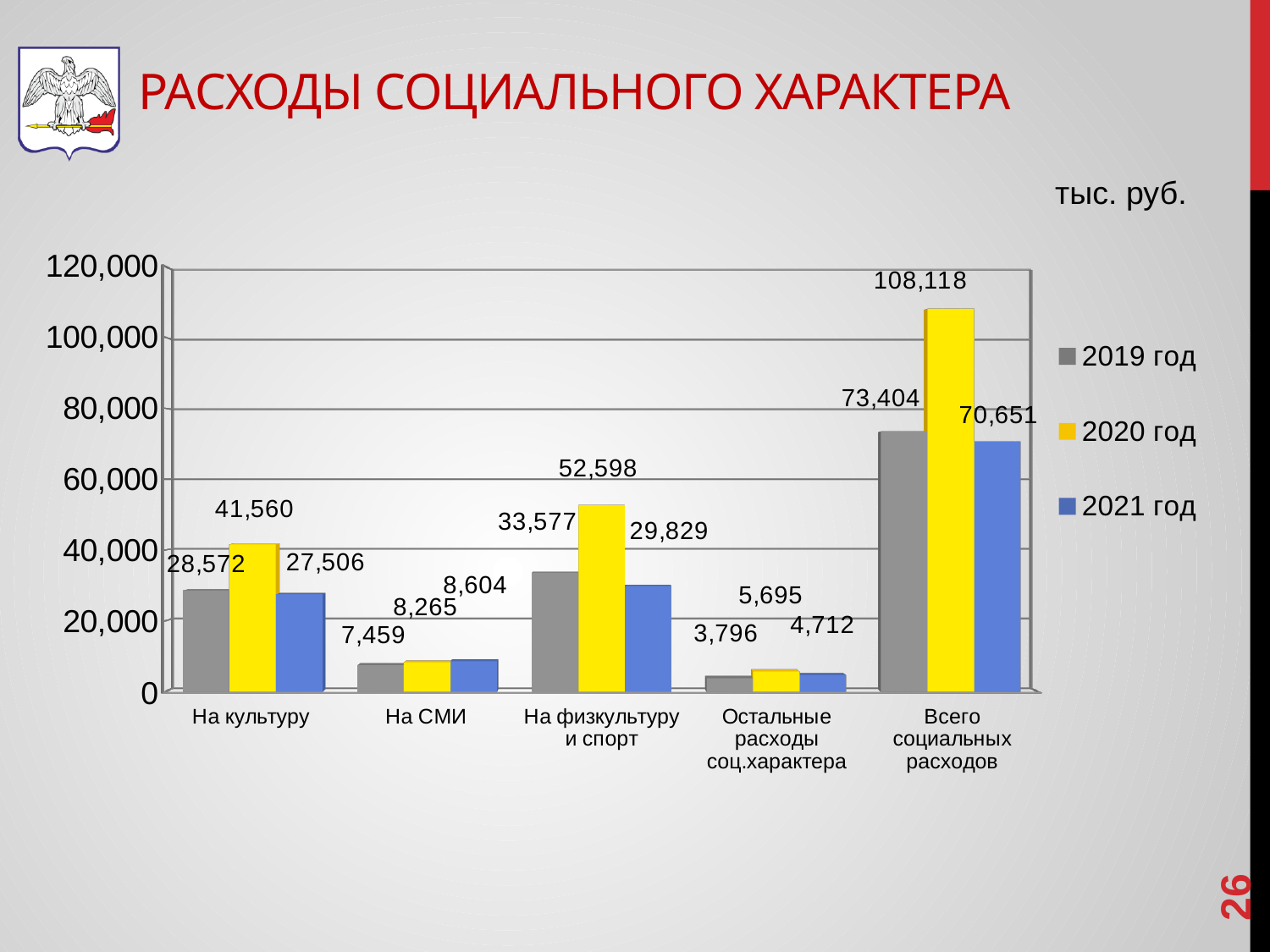
How many series does the legend list? 3 Which year has the highest value in the category Всего социальных расходов? 2020 год What is the difference between the 2020 год and 2019 год values for Всего социальных расходов? 34,714 Which is larger in the category Остальные расходы соц.характера: the 2019 год value or the 2021 год value? 2021 год What type of chart is shown on the slide? bar chart What is the value for 2020 год in the category На культуру? 41,560 How many categories are shown along the x axis? 5 What is the value for 2021 год in the category На физкультуру и спорт? 29,829 What is the value for 2019 год in the category Всего социальных расходов? 73,404 What is the difference between the 2020 год and 2021 год values for На физкультуру и спорт? 22,769 What unit is indicated above the chart? тыс. руб. Which year has the lowest value in the category На СМИ? 2019 год